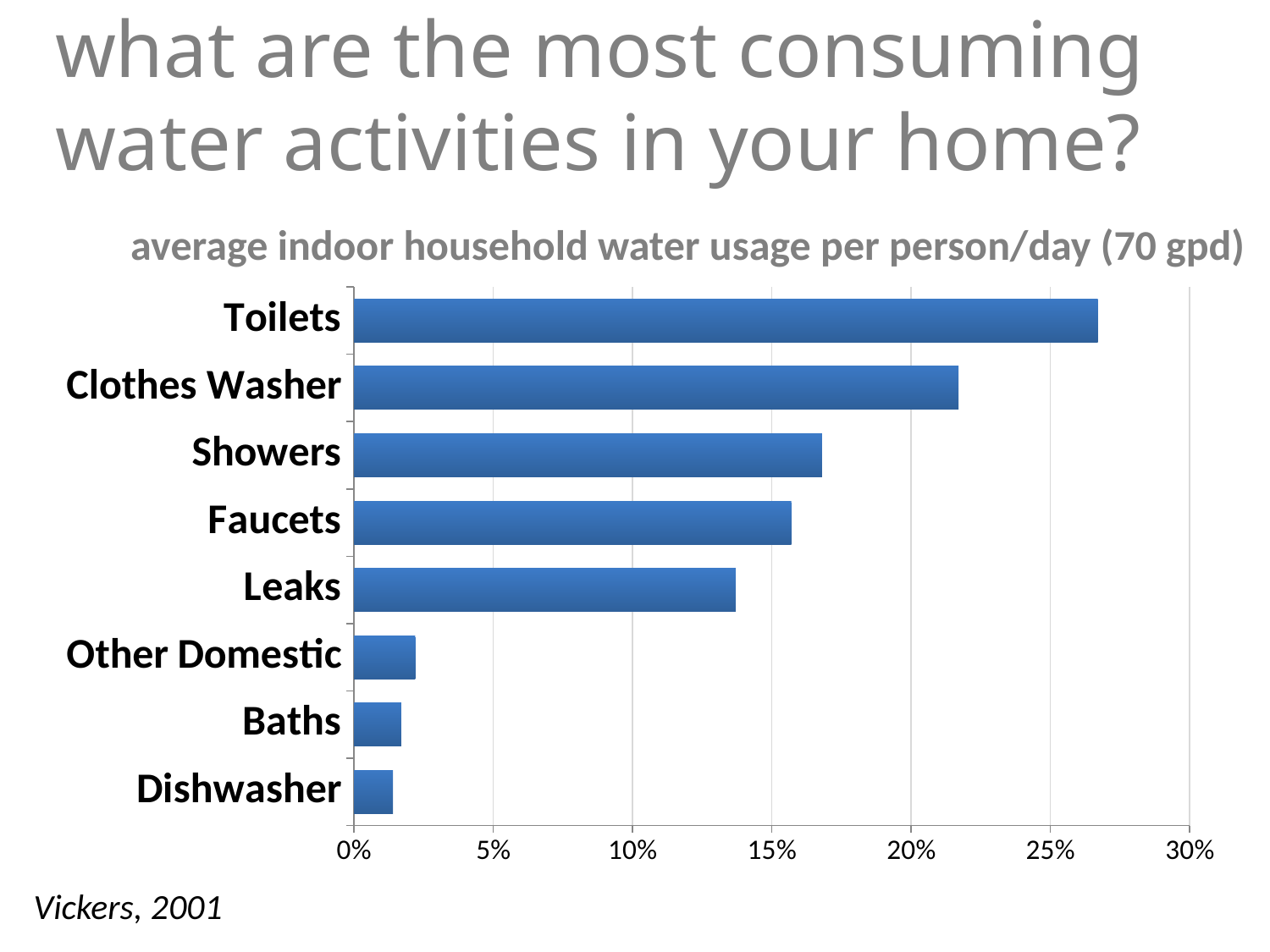
Which category has the lowest water usage share? Dishwasher Is the value for Clothes Washer greater or less than 20%? greater Is the value for Leaks greater or less than 15%? less Which has a larger value, Leaks or Faucets? Faucets Which category has the highest water usage share? Toilets Which has a larger value, Toilets or Clothes Washer? Toilets Is the value for Other Domestic greater or less than 5%? less What is the title of the chart? average indoor household water usage per person/day (70 gpd) What kind of chart is shown on the slide? bar chart How many categories are plotted in the chart? 8 What source is cited below the chart? Vickers, 2001